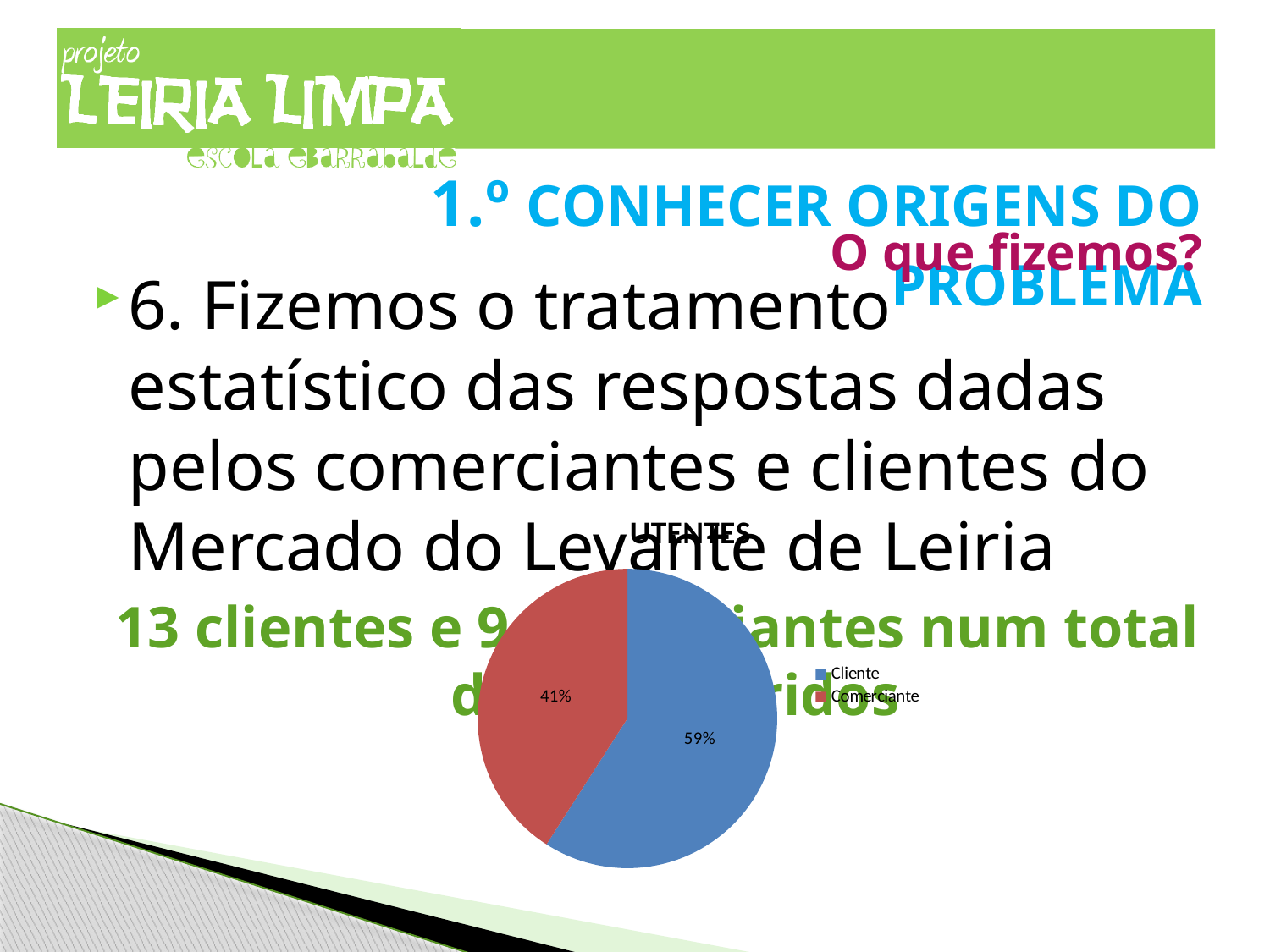
How many slices does the pie chart have? 2 What share of the pie does Cliente represent? 59% Which category has the smallest slice in the pie chart? Comerciante Which category has the largest slice in the pie chart? Cliente How many series does the legend of the pie chart list? 2 Is the share for Comerciante greater or less than 50%? less What colour is the Cliente slice in the pie chart? blue What is the difference in percentage points between the Cliente and Comerciante slices? 18% What share of the pie does Comerciante represent? 41% Which is larger in the pie chart, Cliente or Comerciante? Cliente What is the title of the pie chart? UTENTES What kind of chart is shown on the slide? pie chart